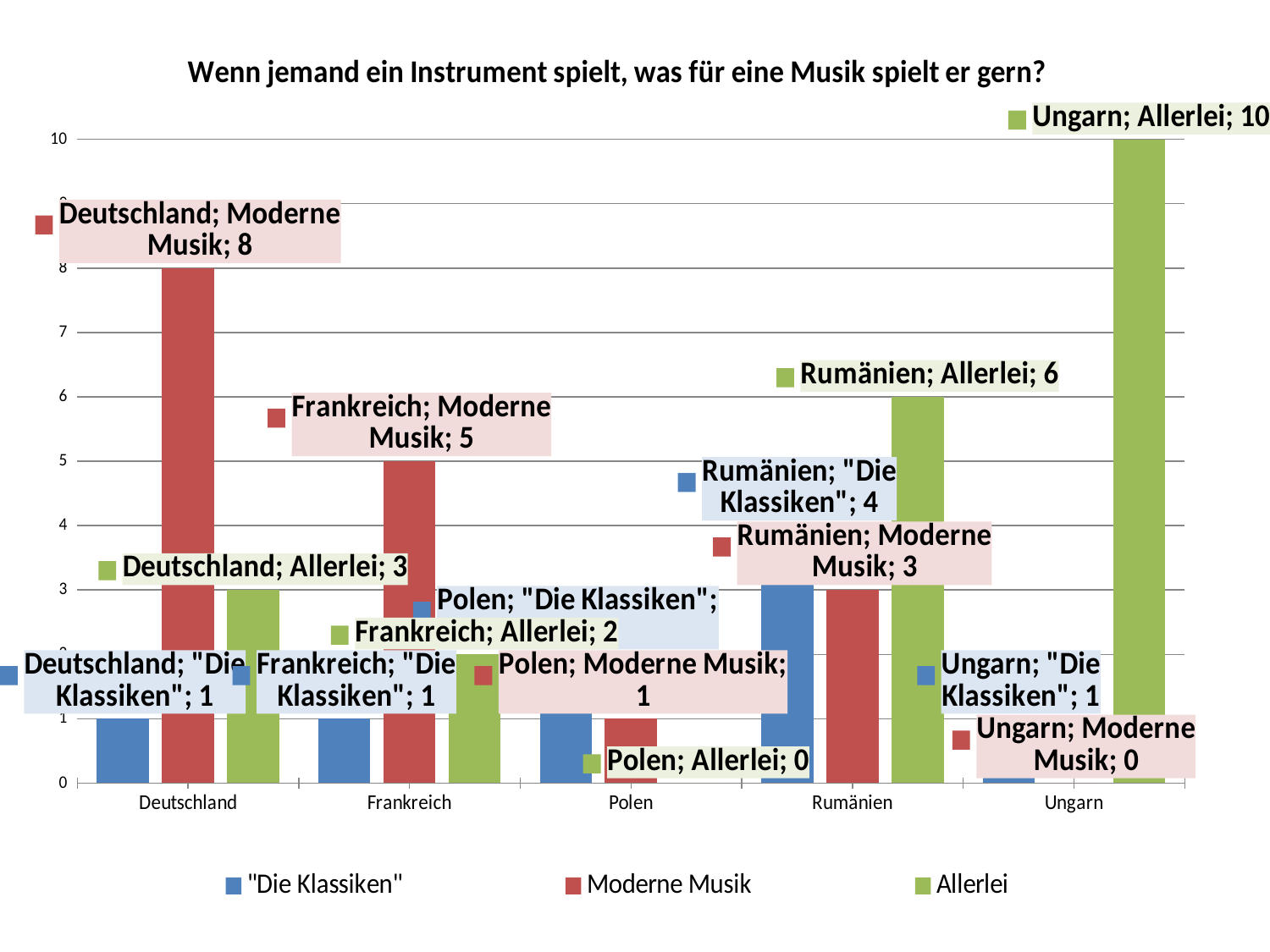
What is the value for Allerlei in Polen? 0 What is the value for Moderne Musik in Deutschland? 8 What type of chart is shown on the slide? bar chart How many countries are shown on the x axis? 5 Which is larger in Frankreich: Moderne Musik or Allerlei? Moderne Musik What is the value for "Die Klassiken" in Rumänien? 4 Which country has the lowest Moderne Musik value? Ungarn What is the difference between the Allerlei values for Ungarn and Rumänien? 4 Which country has the highest Allerlei value? Ungarn How many series does the legend list? 3 What is the value for Allerlei in Ungarn? 10